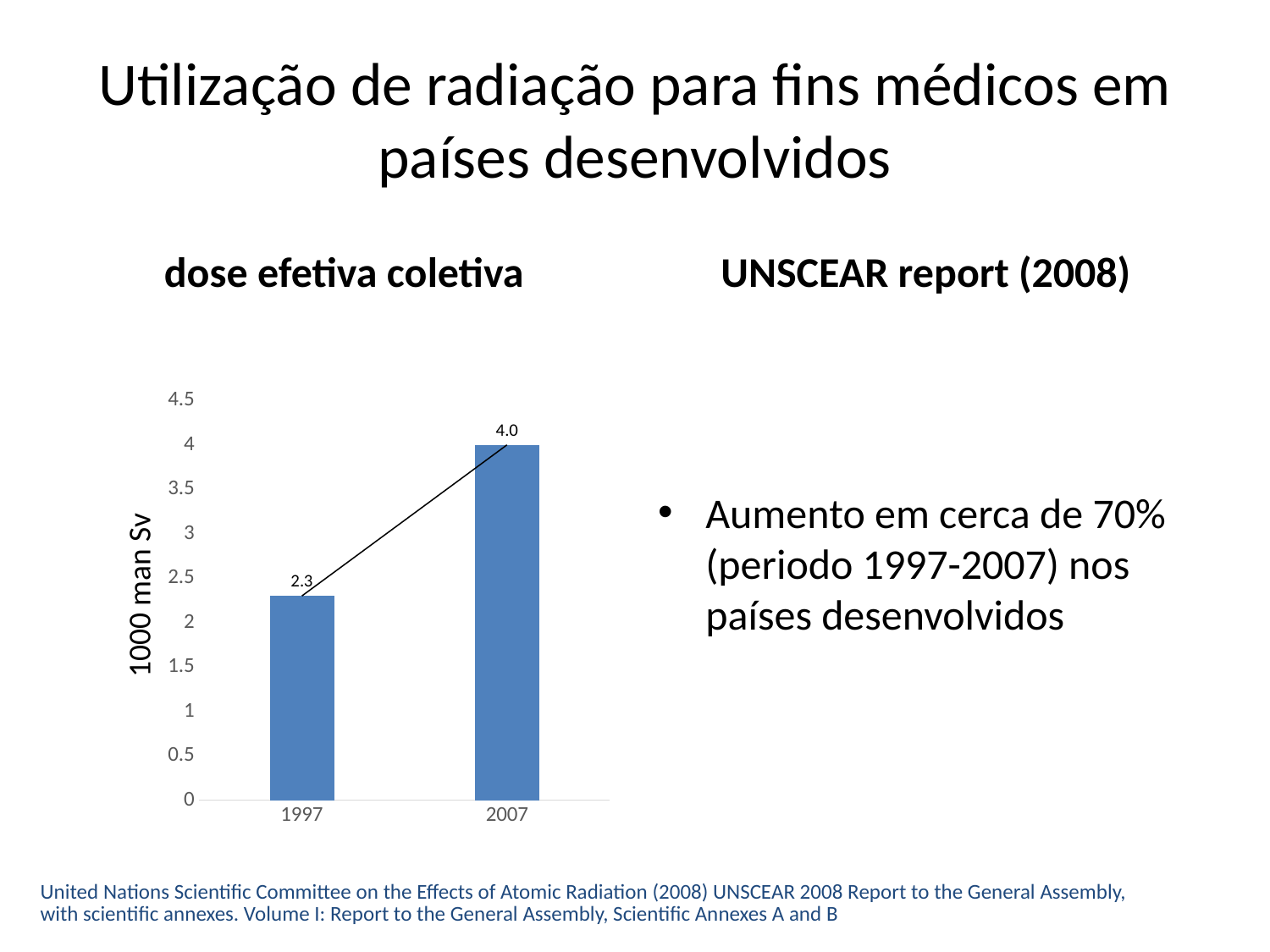
Which is larger, the value for 1997 or the value for 2007? 2007 How many categories are shown on the x axis? 2 Which year has the lowest value? 1997 What kind of chart is shown? bar chart Which year has the highest value? 2007 Do the values rise or fall from 1997 to 2007? rise What is the difference between the values for 2007 and 1997? 1.7 What is the label of the vertical axis? 1000 man Sv Is the value for 1997 greater or less than 2.5? less What is the value for 2007? 4.0 Is the value for 2007 greater or less than 3.5? greater What is the value for 1997? 2.3